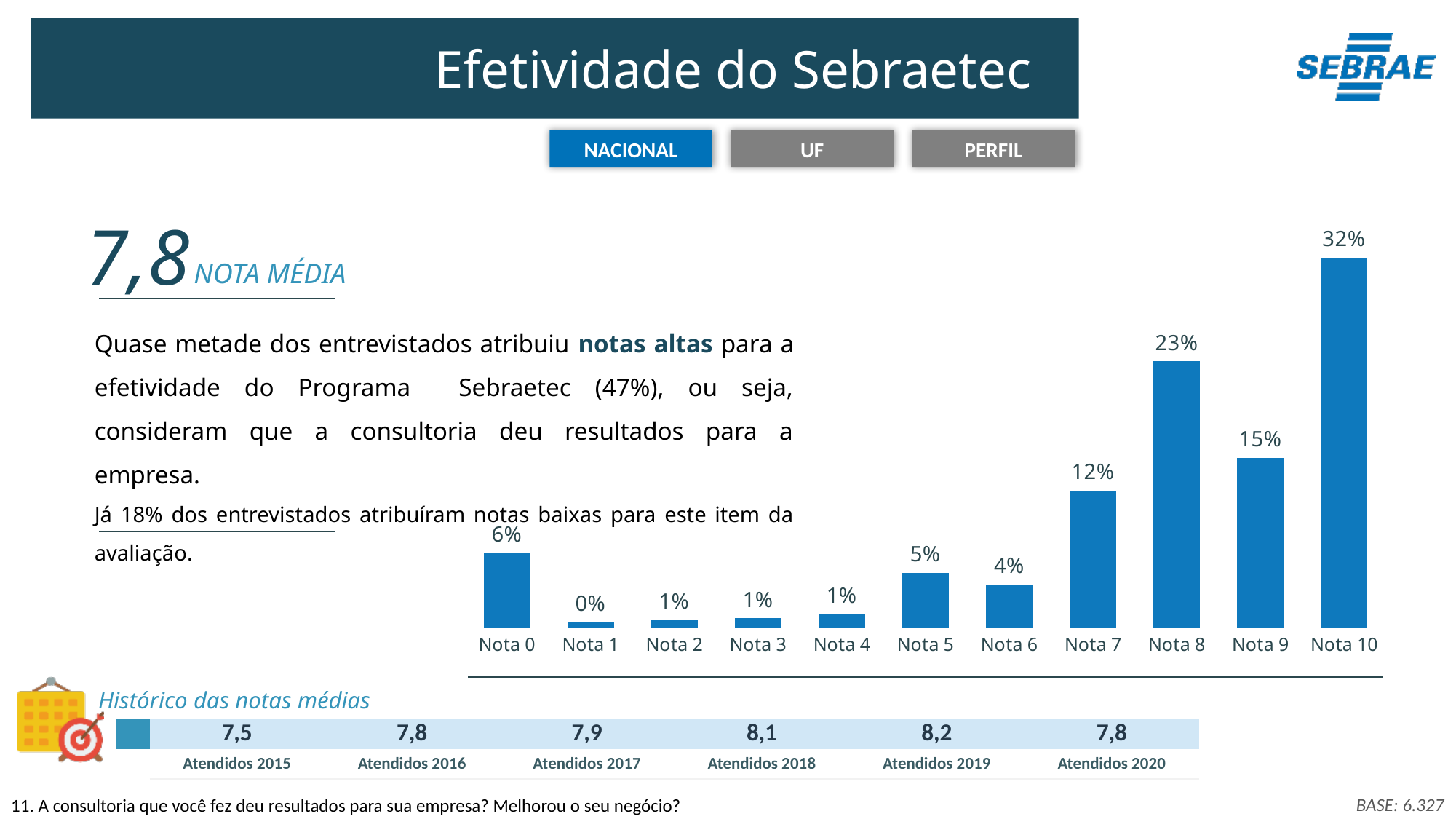
Which category has the lowest value in the bar chart? Nota 1 Which category has the highest value in the bar chart? Nota 10 What is the difference between the values for Nota 10 and Nota 8? 9% What percentage of respondents gave Nota 10? 32% What is the value shown for Nota 8? 23% What percentage is shown for Nota 0? 6% How many categories (notas) are shown on the x axis of the bar chart? 11 What is the difference between the values for Nota 9 and Nota 7? 3% What is the value for Nota 7? 12% What type of chart is used to show the distribution of notas? Bar chart What is the total of the values for Nota 8, Nota 9 and Nota 10? 70% Which is larger, the value for Nota 5 or the value for Nota 6? Nota 5